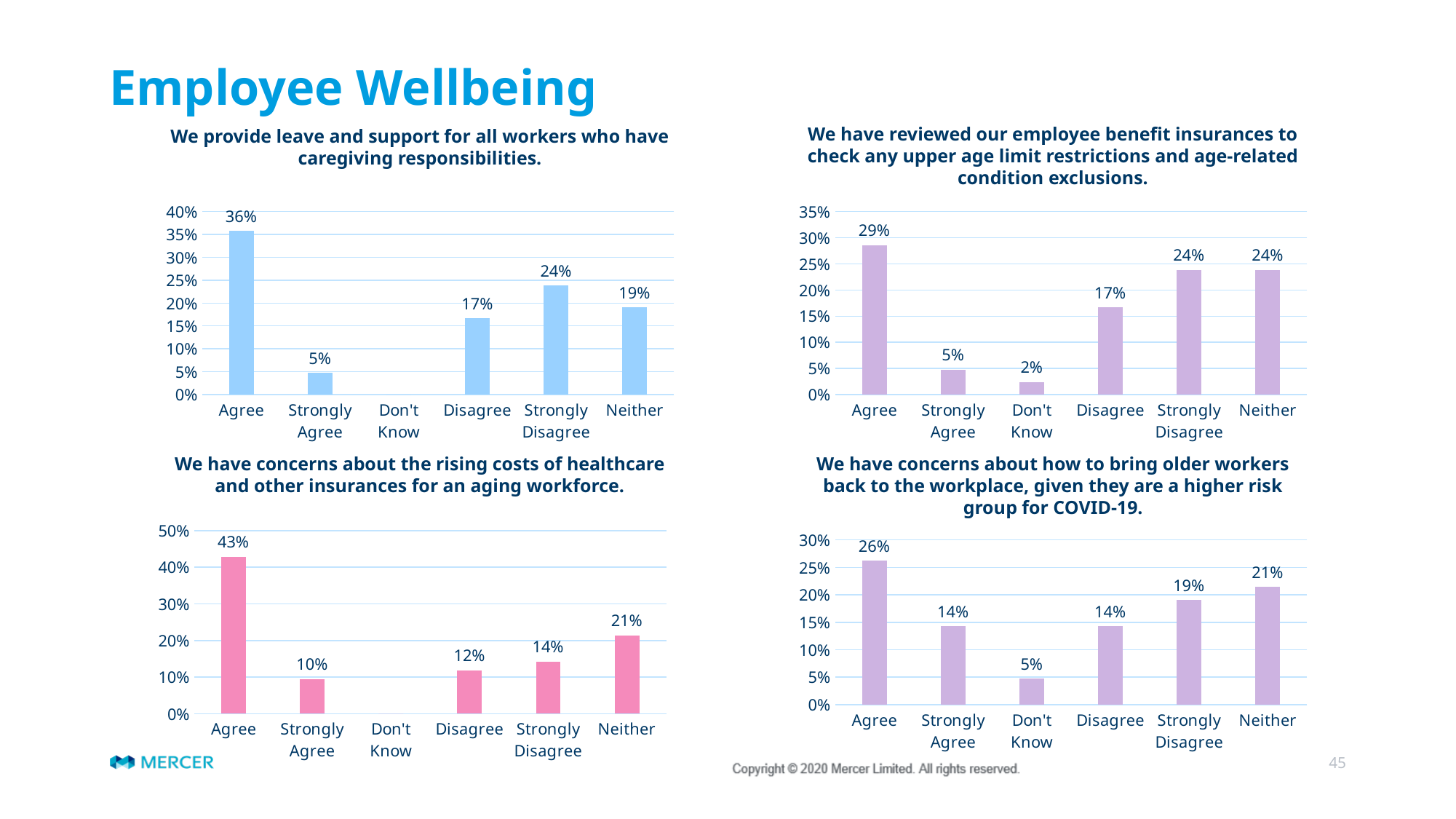
In the bottom-left chart ("We have concerns about the rising costs of healthcare..."), what is the difference between Neither and Strongly Agree? 11% In the top-right chart ("We have reviewed our employee benefit insurances..."), which is larger, Agree or Strongly Disagree? Agree What kind of chart is the bottom-left chart ("We have concerns about the rising costs of healthcare...")? Bar chart In the top-right chart ("We have reviewed our employee benefit insurances..."), what is the value for Don't Know? 2% In the bottom-right chart ("We have concerns about how to bring older workers back to the workplace..."), which is larger, Neither or Strongly Disagree? Neither In the top-left chart ("We provide leave and support for all workers who have caregiving responsibilities"), what is the value for Agree? 36% In the top-right chart ("We have reviewed our employee benefit insurances..."), which category has the lowest value? Don't Know In the top-left chart ("We provide leave and support for all workers who have caregiving responsibilities"), which category has the highest value? Agree In the top-left chart ("We provide leave and support for all workers who have caregiving responsibilities"), what is the difference between Strongly Disagree and Disagree? 7% How many categories are shown on the x axis of the bottom-right chart ("We have concerns about how to bring older workers back to the workplace...")? 6 In the bottom-left chart ("We have concerns about the rising costs of healthcare..."), what is the value for Agree? 43% In the bottom-right chart ("We have concerns about how to bring older workers back to the workplace..."), what is the value for Strongly Disagree? 19%